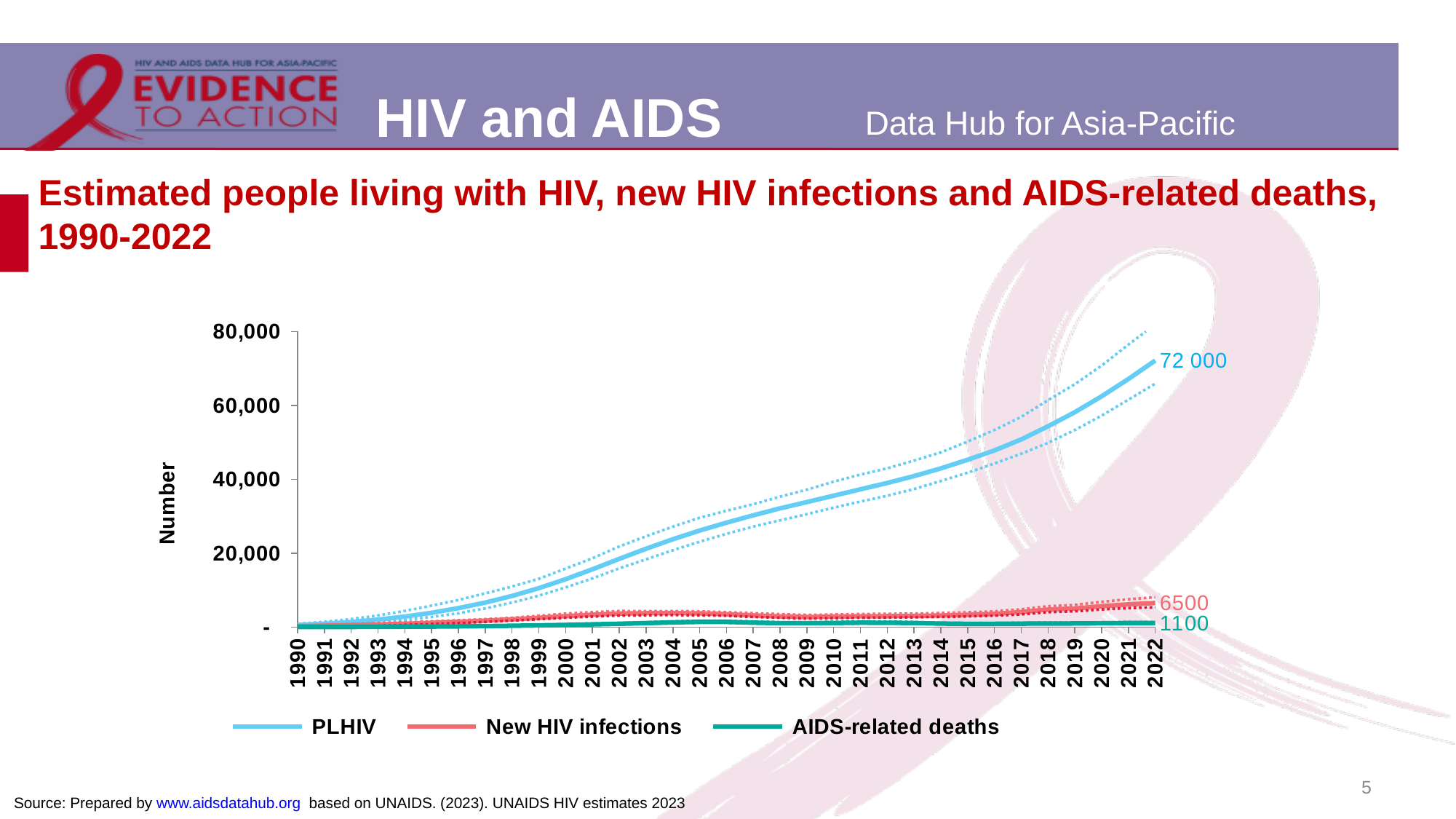
What is the difference between New HIV infections and AIDS-related deaths in 2022? 5400 Which series has the lowest value in 2022? AIDS-related deaths Is the value for PLHIV in 2015 greater or less than 40,000? greater How many series does the legend list? 3 Which series has the highest value in 2022? PLHIV In 2022, which is larger: PLHIV or New HIV infections? PLHIV How many years are shown on the x axis? 33 What is the value for New HIV infections in 2022? 6500 What is the value for AIDS-related deaths in 2022? 1100 What kind of chart is shown on the slide? Line chart What is the value for PLHIV in 2022? 72 000 Is the value for PLHIV in 2000 greater or less than 20,000? less